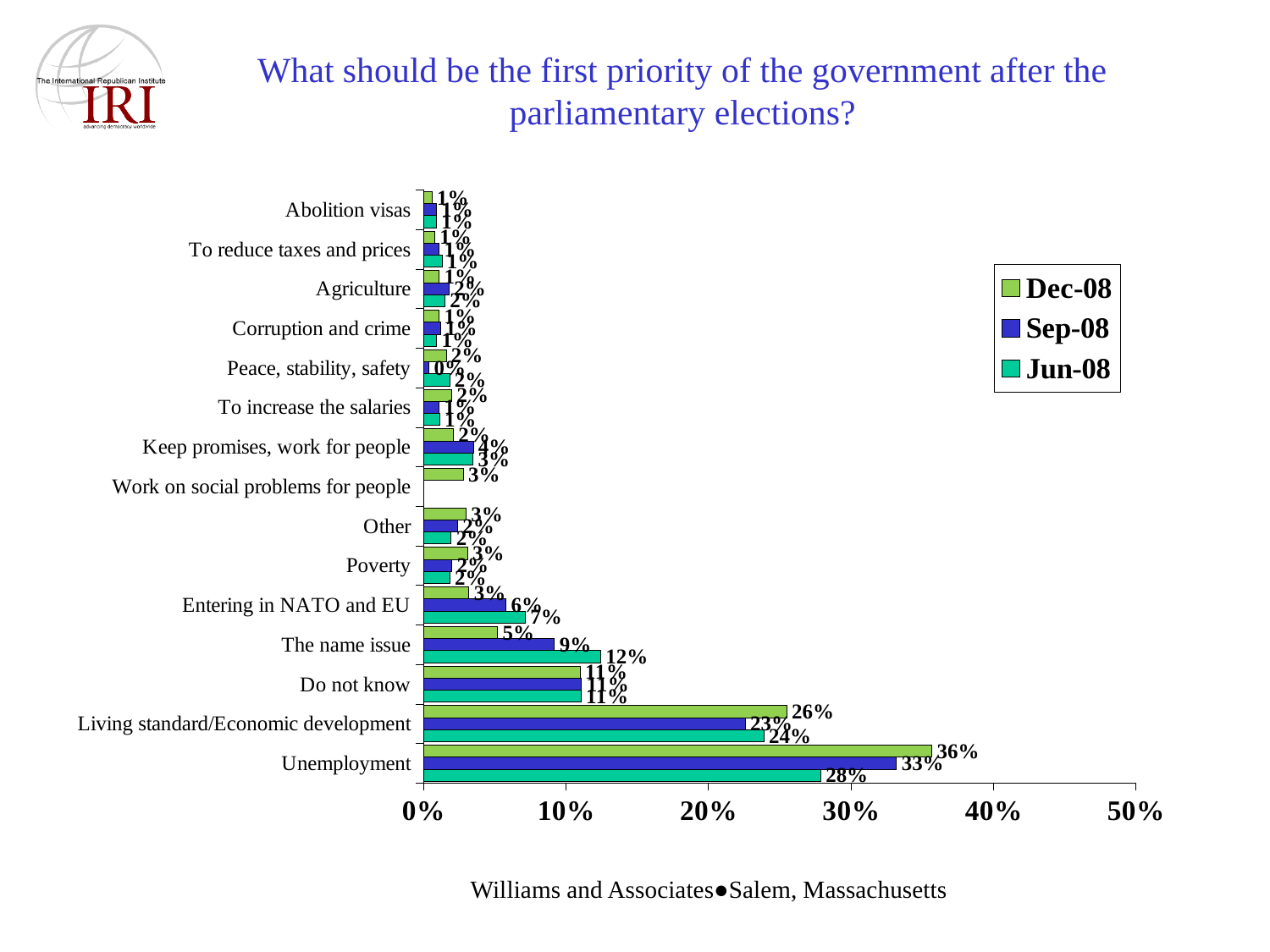
What is the Jun-08 value for Unemployment? 28% For Living standard/Economic development, which is larger: the Dec-08 value or the Sep-08 value? Dec-08 What is the Sep-08 value for Entering in NATO and EU? 6% What kind of chart is shown on the slide? Bar chart Which category has the highest value in the Dec-08 series? Unemployment How many categories are shown on the chart? 15 How many series does the legend list? 3 What is the difference between the Dec-08 and Jun-08 values for Unemployment? 8 percentage points Is the Jun-08 value for Living standard/Economic development greater or less than 20%? greater What is the Jun-08 value for The name issue? 12% What is the Dec-08 value for Unemployment? 36% What are the three entries in the legend? Dec-08, Sep-08, Jun-08